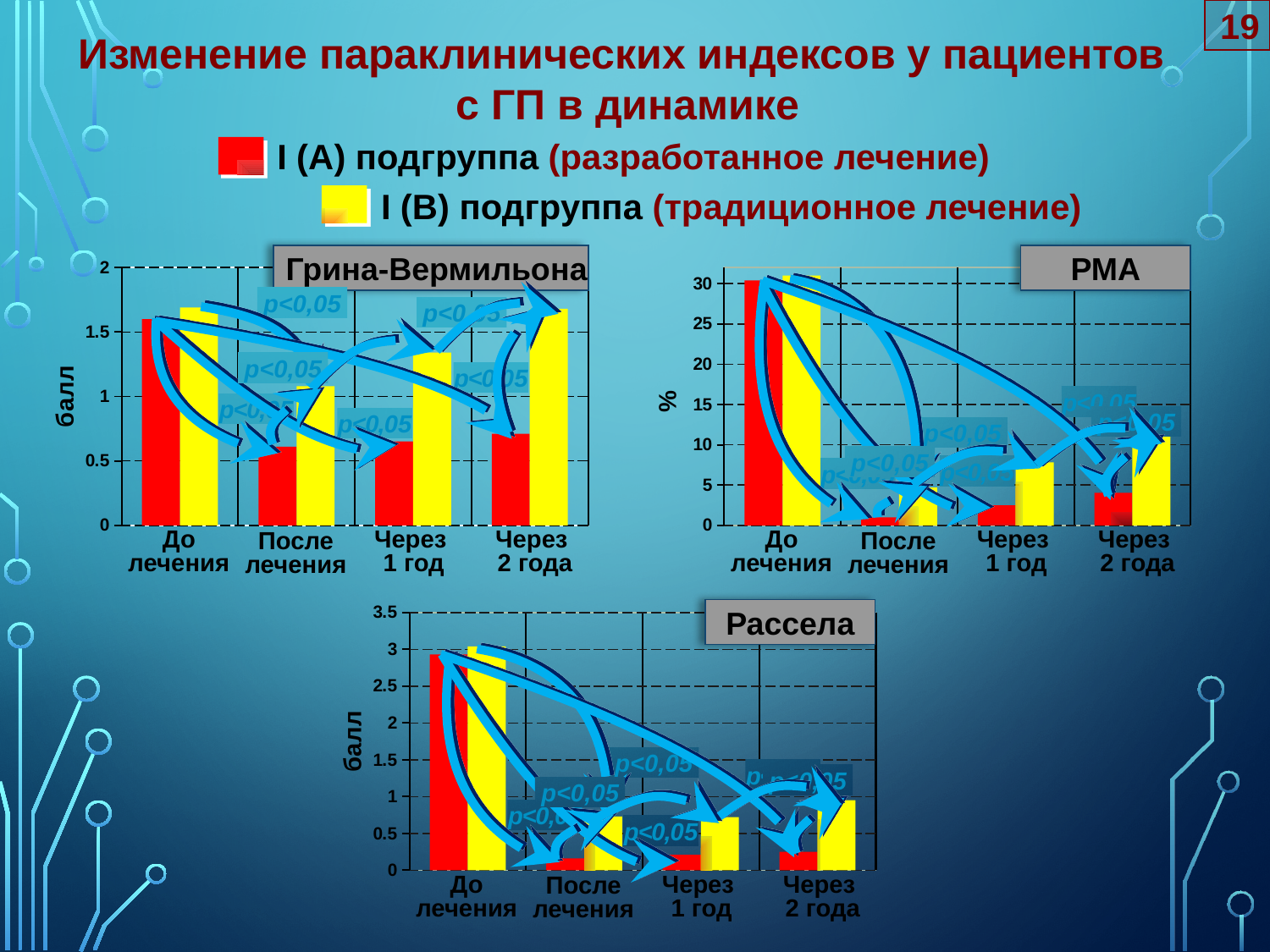
How many categories are shown on the x axis of the "РМА" chart? 4 What kind of chart is the "Грина-Вермильона" chart? bar chart In the "Рассела" chart, is the value for I (B) подгруппа at "До лечения" greater or less than 2.5? greater In the "РМА" chart, is the value for I (A) подгруппа at "После лечения" greater or less than 5? less In the "Рассела" chart, is the value for I (A) подгруппа at "Через 1 год" greater or less than 0.5? less What is the y-axis label of the "РМА" chart? % In the "РМА" chart, at which category is the value for I (A) подгруппа highest? До лечения How many series does the legend at the top of the slide list? 2 In the "Грина-Вермильона" chart, which is larger at "Через 2 года": I (A) подгруппа or I (B) подгруппа? I (B) подгруппа In the "Рассела" chart, does the value for I (A) подгруппа rise or fall from "До лечения" to "После лечения"? fall